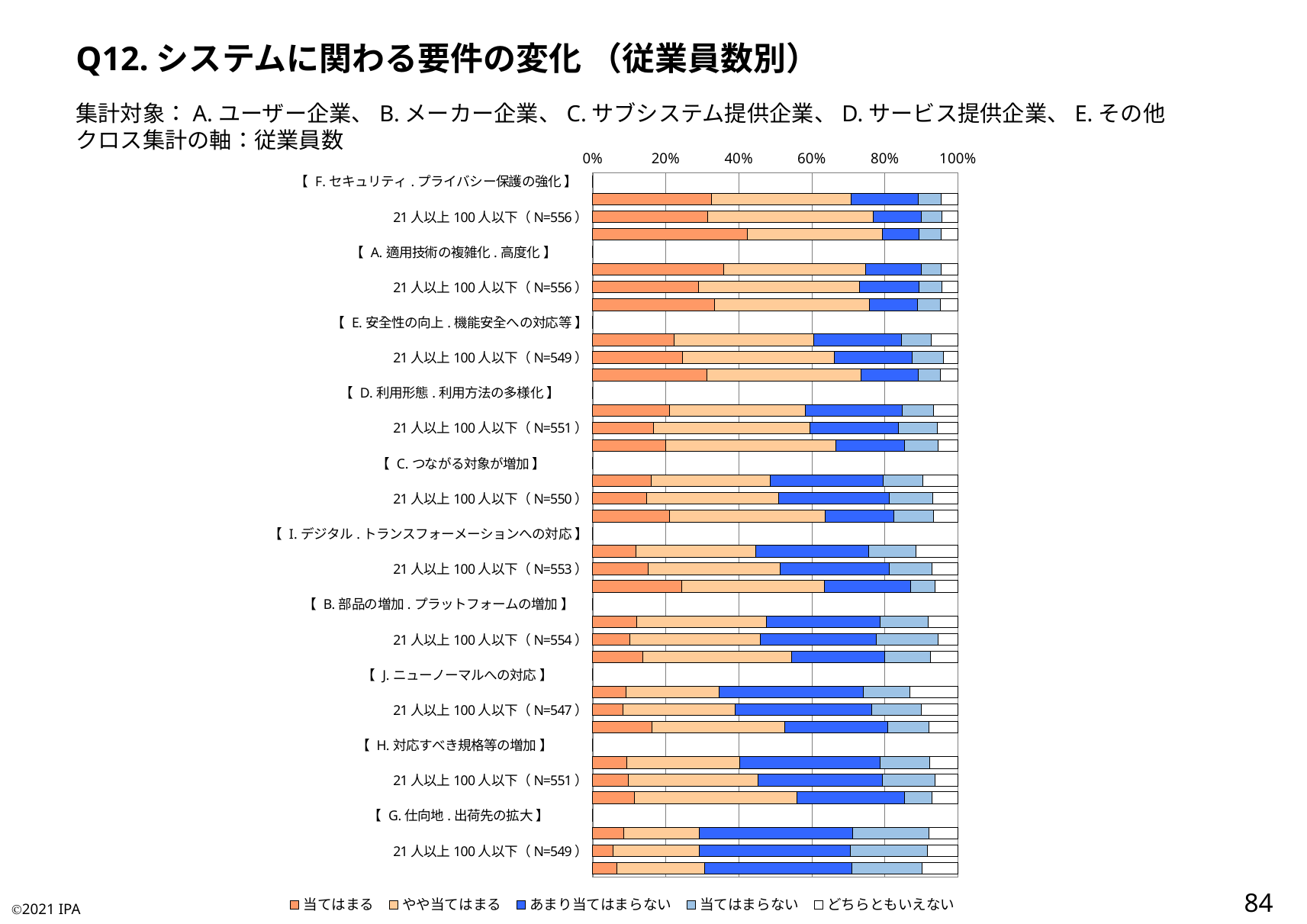
How many series does the legend list? 5 What is the N value shown for the 21人以上100人以下 bar in the 【E. 安全性の向上.機能安全への対応等】 group? N=549 Is the 当てはまる share for the 21人以上100人以下 (N=556) bar in the 【A. 適用技術の複雑化.高度化】 group greater or less than 20%? greater Which has the larger 当てはまる share for its 21人以上100人以下 bar: the 【F. セキュリティ.プライバシー保護の強化】 group or the 【G. 仕向地.出荷先の拡大】 group? 【F. セキュリティ.プライバシー保護の強化】 Is the 当てはまる share for the 21人以上100人以下 (N=549) bar in the 【G. 仕向地.出荷先の拡大】 group greater or less than 20%? less Is the 当てはまる share for the 21人以上100人以下 (N=556) bar in the 【F. セキュリティ.プライバシー保護の強化】 group greater or less than 20%? greater What kind of chart is shown on the slide? bar chart What is the first entry in the legend? 当てはまる How many bracketed requirement groups (【 】 headings) are listed on the chart? 10 How many bars are plotted under each bracketed requirement group? 3